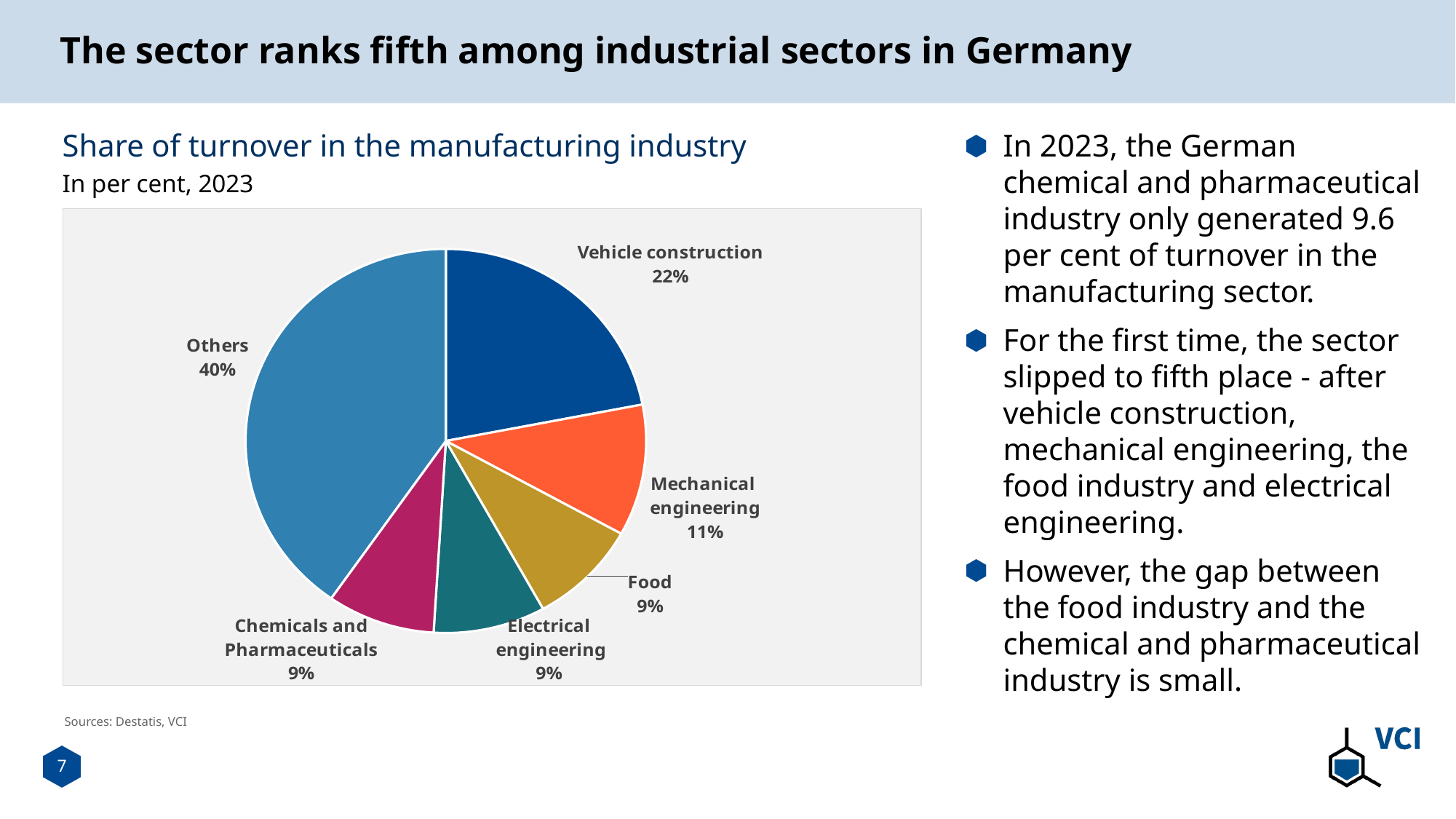
Which named industrial sector (excluding Others) has the largest share? Vehicle construction What share does the Food slice represent? 9% What is the share of the Others slice? 40% By how many percentage points does Vehicle construction exceed Mechanical engineering? 11 percentage points What type of chart is shown on the slide? Pie chart What is the share for Mechanical engineering? 11% How many slices does the pie chart have? 6 Which has a larger share, Vehicle construction or Mechanical engineering? Vehicle construction What share of turnover is attributed to Chemicals and Pharmaceuticals? 9% What is the title of the chart? Share of turnover in the manufacturing industry What share of turnover does Vehicle construction hold in the pie chart? 22% Which slice of the pie chart is the largest? Others